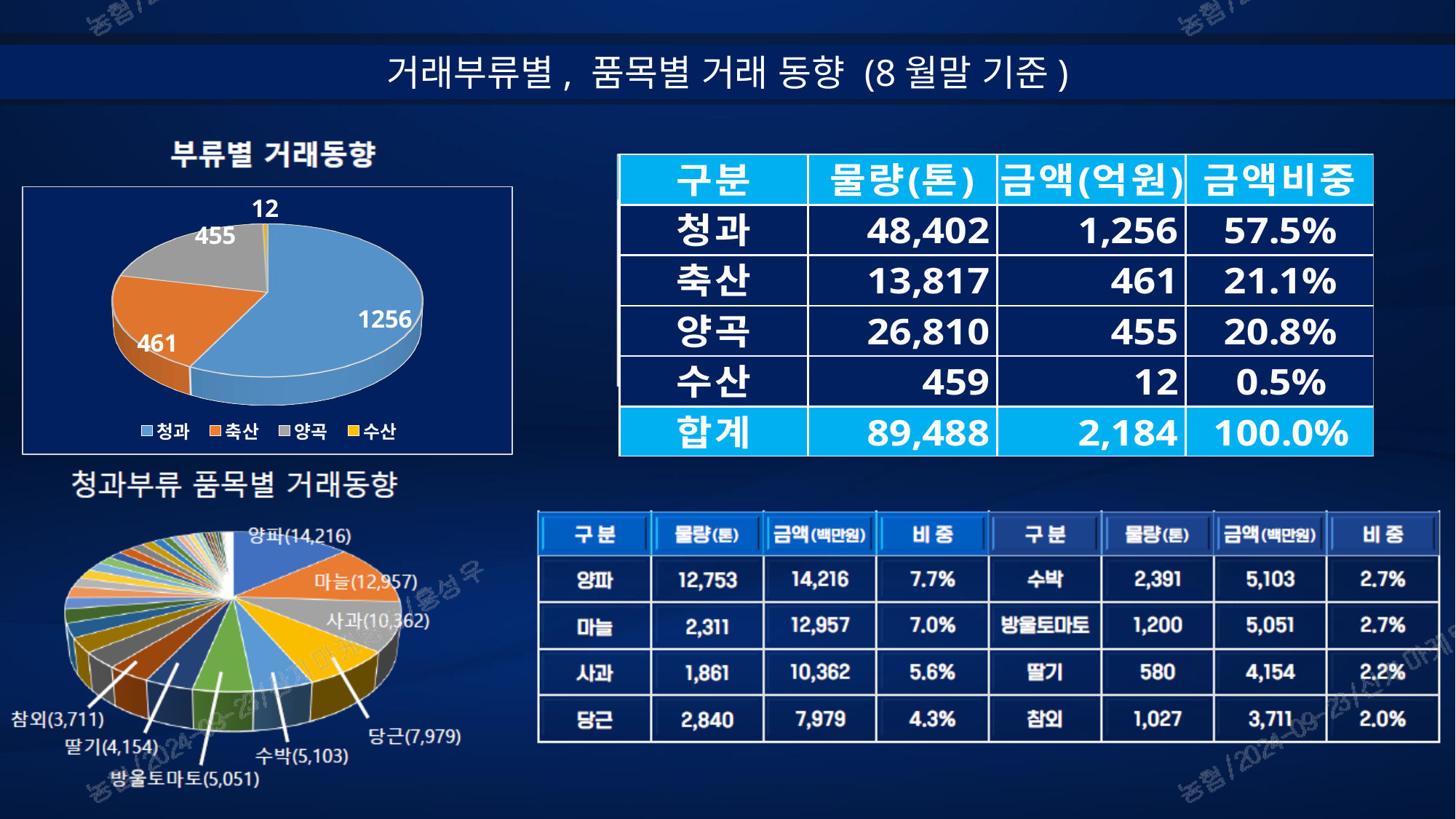
In the '부류별 거래동향' pie chart, what is the value shown for 청과? 1256 How many categories does the legend of the '부류별 거래동향' pie chart list? 4 In the '부류별 거래동향' pie chart, which category has the smallest slice? 수산 In the '부류별 거래동향' pie chart, which is larger, the value for 축산 or the value for 수산? 축산 In the '부류별 거래동향' pie chart, what is the value shown for 양곡? 455 In the '부류별 거래동향' pie chart, what is the difference between the values for 축산 and 양곡? 6 In the '부류별 거래동향' pie chart, what is the total of the four slice values? 2184 In the '청과부류 품목별 거래동향' pie chart, which is larger, the value for 사과 or the value for 당근? 사과 In the '부류별 거래동향' pie chart, which category has the largest slice? 청과 In the '청과부류 품목별 거래동향' pie chart, what value is shown for 양파? 14,216 In the '청과부류 품목별 거래동향' pie chart, what value is shown for 방울토마토? 5,051 What kind of chart is '부류별 거래동향'? pie chart